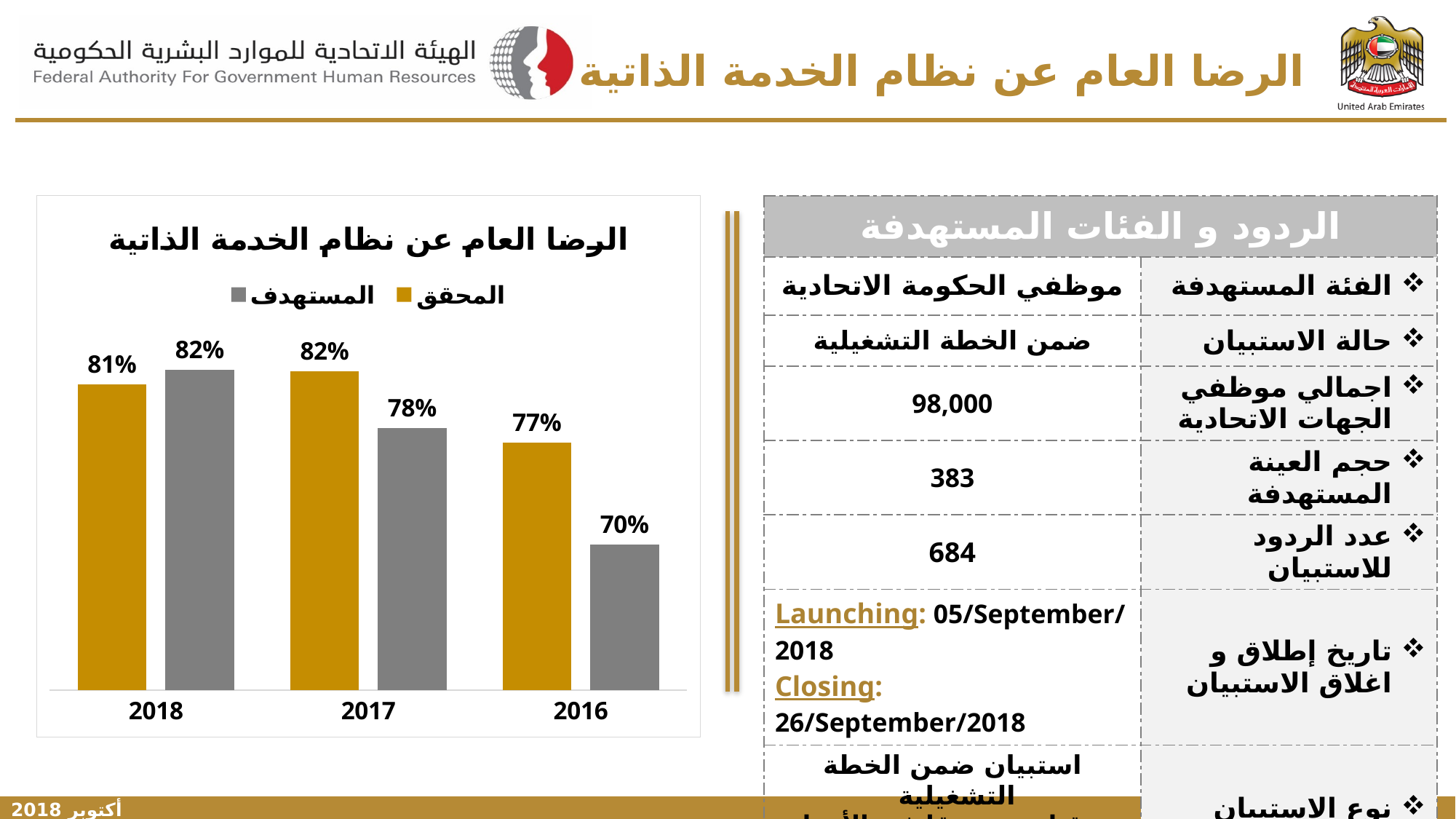
What is the value of المحقق for 2018? 81% Which year has the lowest value for المستهدف? 2016 Which year has the highest value for المحقق? 2017 How many years are shown on the x axis of the chart? 3 What is the difference between المحقق and المستهدف for 2017? 4% What kind of chart is shown on the slide? Bar chart What is the value of المحقق for 2016? 77% How many series does the chart legend list? 2 What is the value of المستهدف for 2017? 78% For 2018, which is larger, المحقق or المستهدف? المستهدف What is the value of المستهدف for 2016? 70% What is the difference between المحقق and المستهدف for 2016? 7%